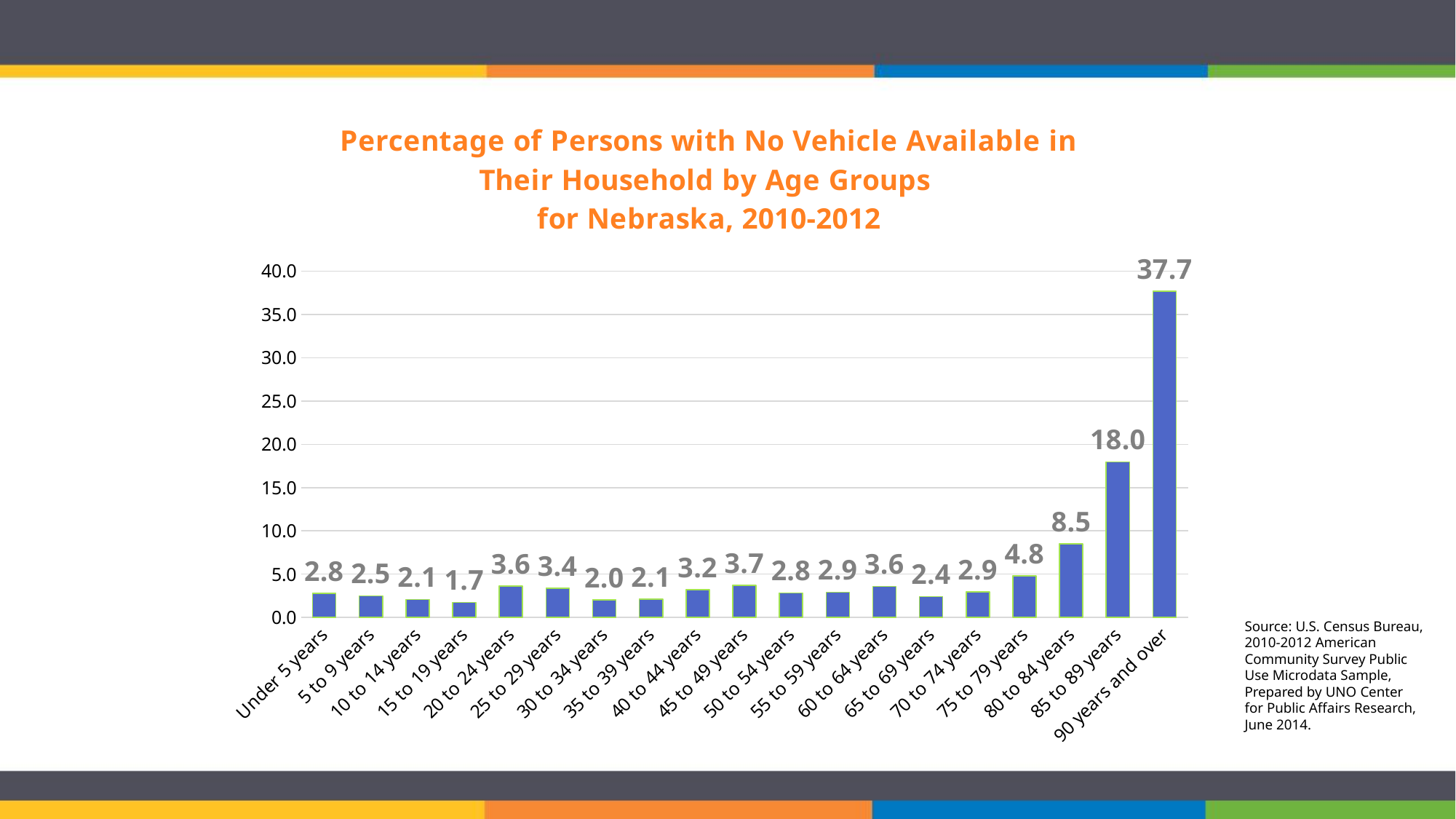
How many age groups are shown on the x axis? 19 What is the difference between the values for 90 years and over and 85 to 89 years? 19.7 What value is shown for the 15 to 19 years age group? 1.7 Which has a larger value, 20 to 24 years or 25 to 29 years? 20 to 24 years What is the difference between the values for 80 to 84 years and 75 to 79 years? 3.7 What is the percentage of persons with no vehicle available for the 90 years and over age group? 37.7 What value is shown for the 45 to 49 years age group? 3.7 Which age group has the lowest percentage of persons with no vehicle available? 15 to 19 years What value is shown for the 85 to 89 years age group? 18.0 What is the title of the chart? Percentage of Persons with No Vehicle Available in Their Household by Age Groups for Nebraska, 2010-2012 What kind of chart is shown on the slide? Bar chart Which age group has the highest percentage of persons with no vehicle available? 90 years and over